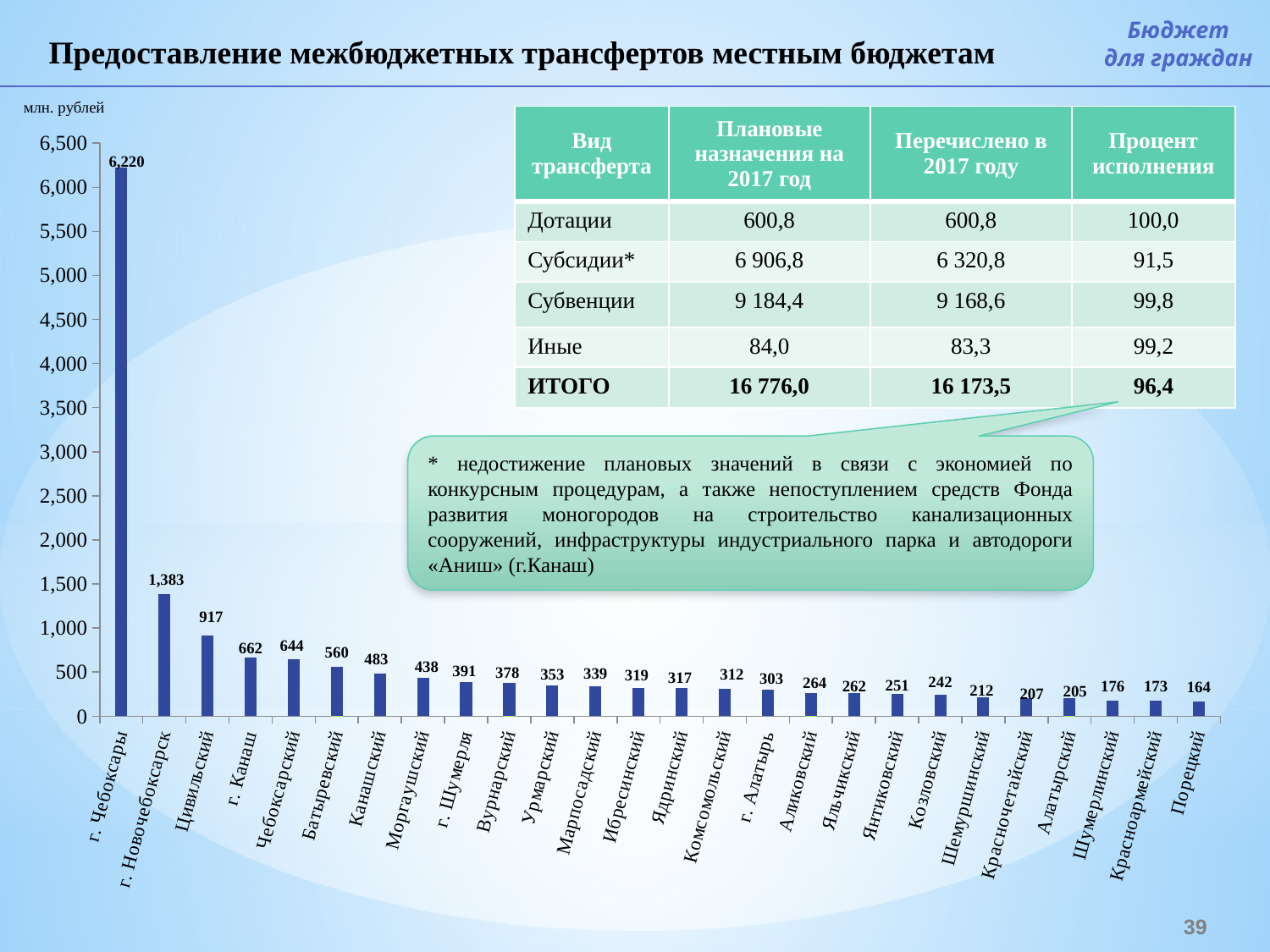
What unit is indicated above the chart's vertical axis? млн. рублей Which category has the lowest value? Порецкий What is the value for Козловский? 242 Is the value for Моргаушский greater or less than 500? less What is the value for Батыревский? 560 Which is larger, the value for г. Канаш or the value for Чебоксарский? г. Канаш Which category has the highest value? г. Чебоксары What is the difference between the values for г. Новочебоксарск and Цивильский? 466 What is the value for г. Чебоксары? 6,220 What kind of chart is shown on the slide? bar chart Do the values rise or fall from left to right along the x axis? fall How many categories are shown on the x axis? 26